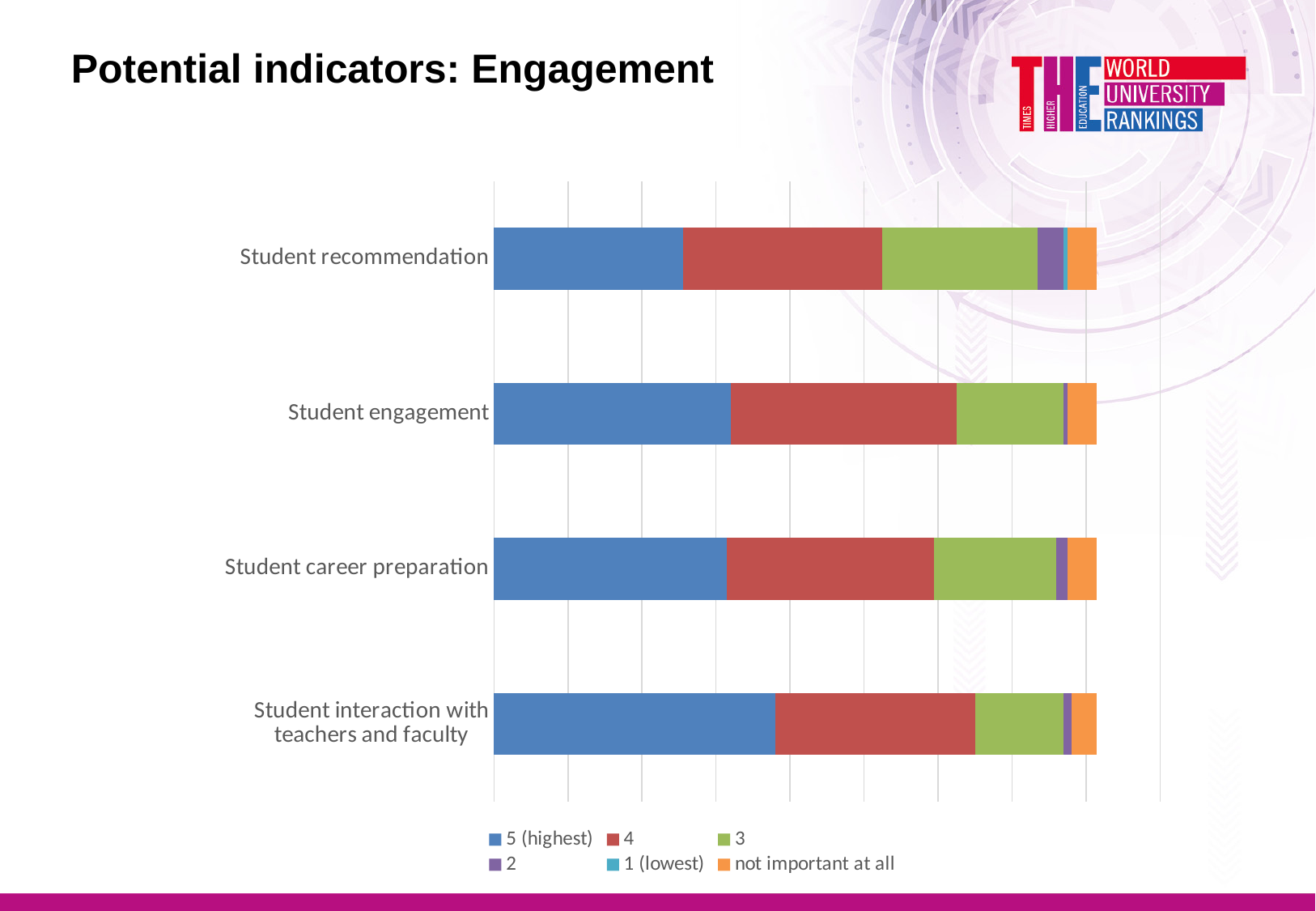
Which category has the largest '5 (highest)' segment? Student interaction with teachers and faculty How many series does the legend list? 6 What is the title of the slide containing the chart? Potential indicators: Engagement Is the '5 (highest)' segment larger for Student interaction with teachers and faculty or for Student recommendation? Student interaction with teachers and faculty What is the last entry listed in the chart legend? not important at all How many categories (indicators) are plotted on the chart? 4 What kind of chart is shown on the slide? Stacked bar chart Which category has the largest '3' segment? Student recommendation Which category is the only one with a visible '1 (lowest)' segment? Student recommendation Is the '3' segment larger for Student recommendation or for Student interaction with teachers and faculty? Student recommendation Which category has the smallest '5 (highest)' segment? Student recommendation